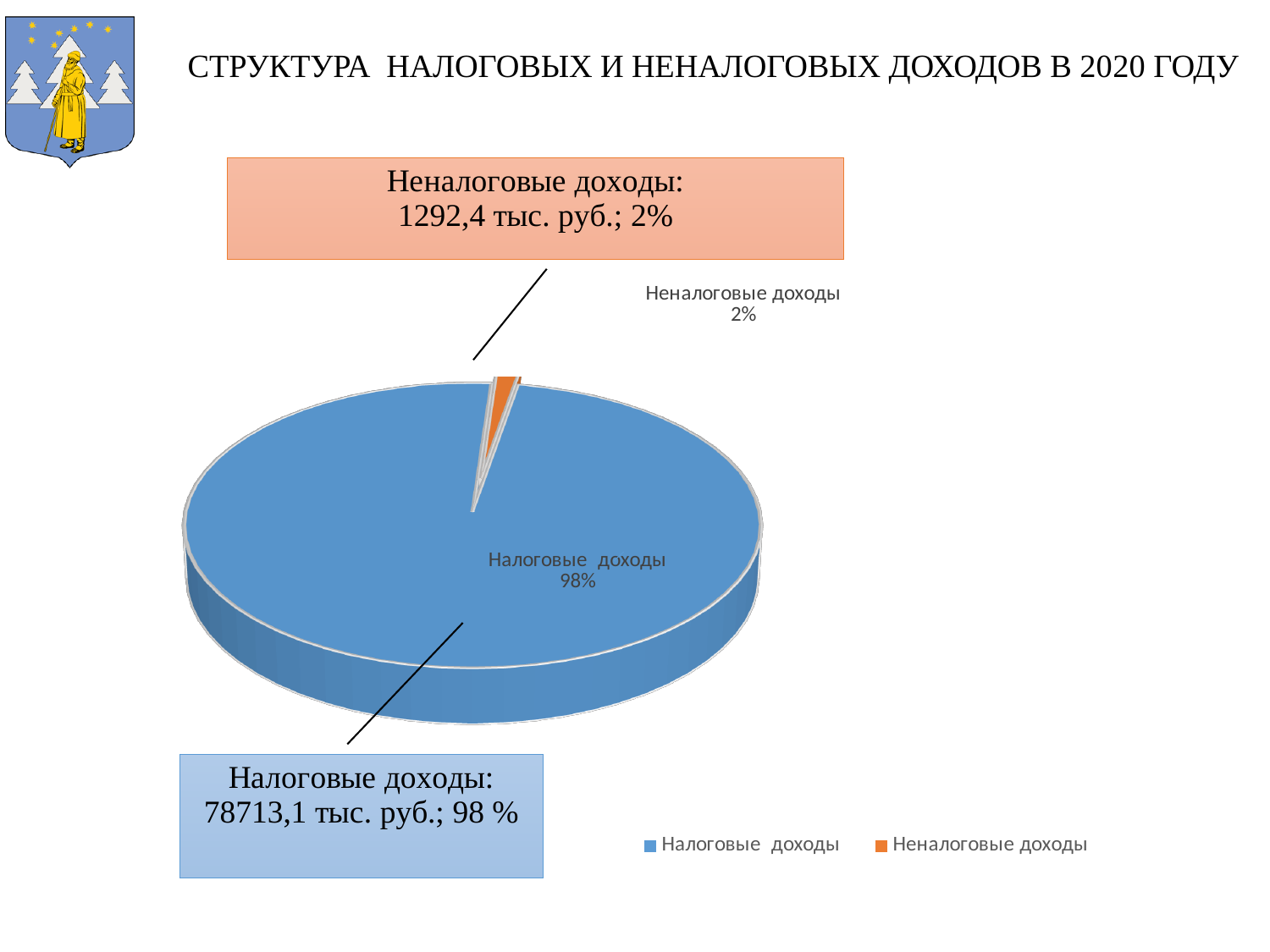
What share of the pie does Налоговые доходы take? 98% Which category has the largest slice of the pie? Налоговые доходы Which category has the smallest slice of the pie? Неналоговые доходы How many slices does the pie chart have? 2 What is the difference in тыс. руб. between Налоговые доходы and Неналоговые доходы? 77420,7 тыс. руб. What is the value for Неналоговые доходы in тыс. руб.? 1292,4 тыс. руб. What kind of chart is shown on the slide? pie chart Which is larger, Налоговые доходы or Неналоговые доходы? Налоговые доходы What is the title of the slide? СТРУКТУРА НАЛОГОВЫХ И НЕНАЛОГОВЫХ ДОХОДОВ В 2020 ГОДУ How many entries does the legend list? 2 What is the value for Налоговые доходы in тыс. руб.? 78713,1 тыс. руб. What share of the pie does Неналоговые доходы take? 2%